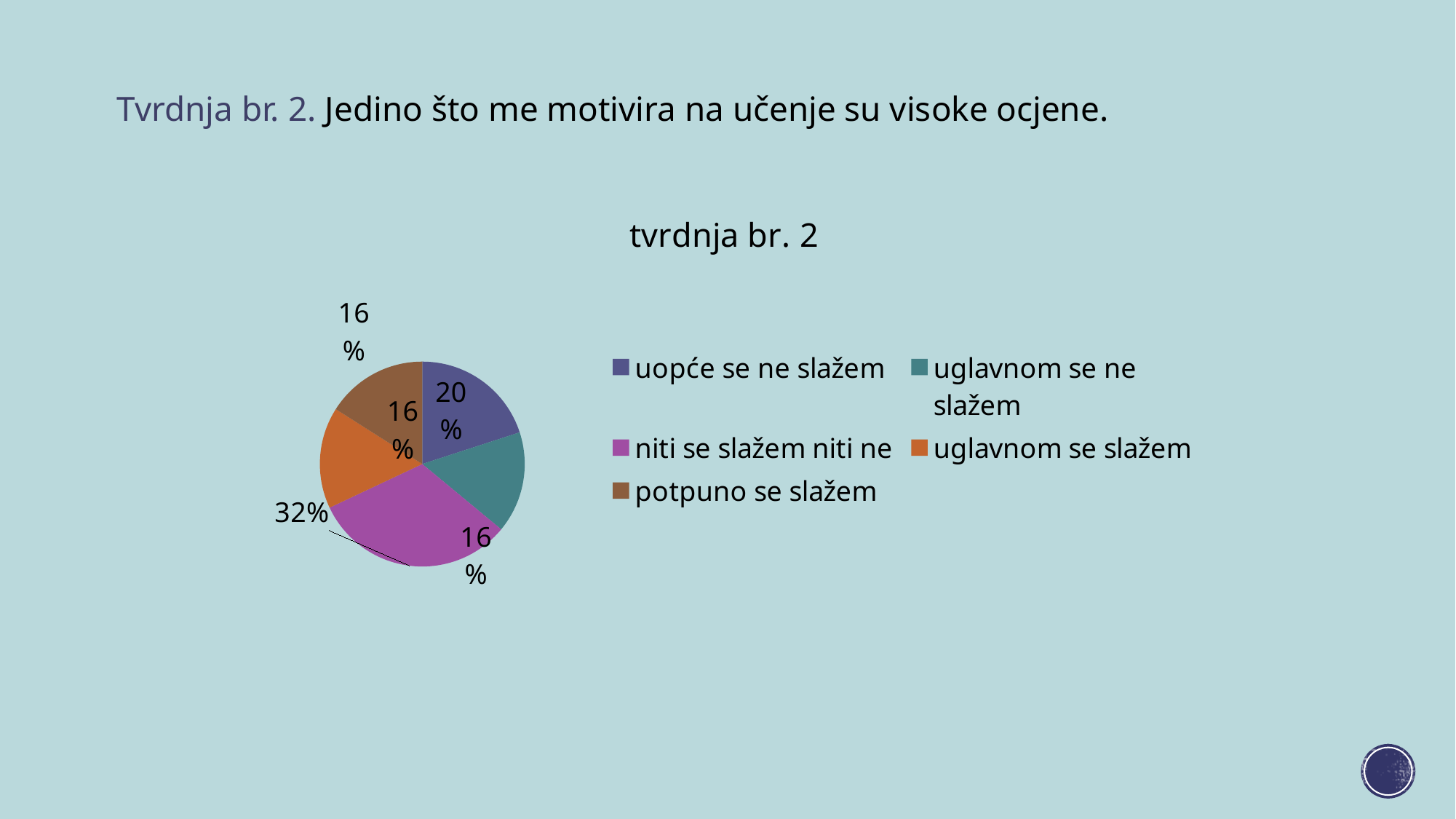
What share of the pie is 'niti se slažem niti ne'? 32% Which category has the largest slice of the pie? niti se slažem niti ne Which is larger, 'uopće se ne slažem' or 'uglavnom se slažem'? uopće se ne slažem Which colour represents 'uglavnom se slažem' in the pie chart? orange What share of the pie is 'potpuno se slažem'? 16% What is the difference between the shares of 'niti se slažem niti ne' and 'uopće se ne slažem'? 12% What kind of chart is shown on the slide? pie chart What is the title of the chart? tvrdnja br. 2 How many slices does the pie chart have? 5 What share of the pie is 'uglavnom se ne slažem'? 16% How many entries does the legend list? 5